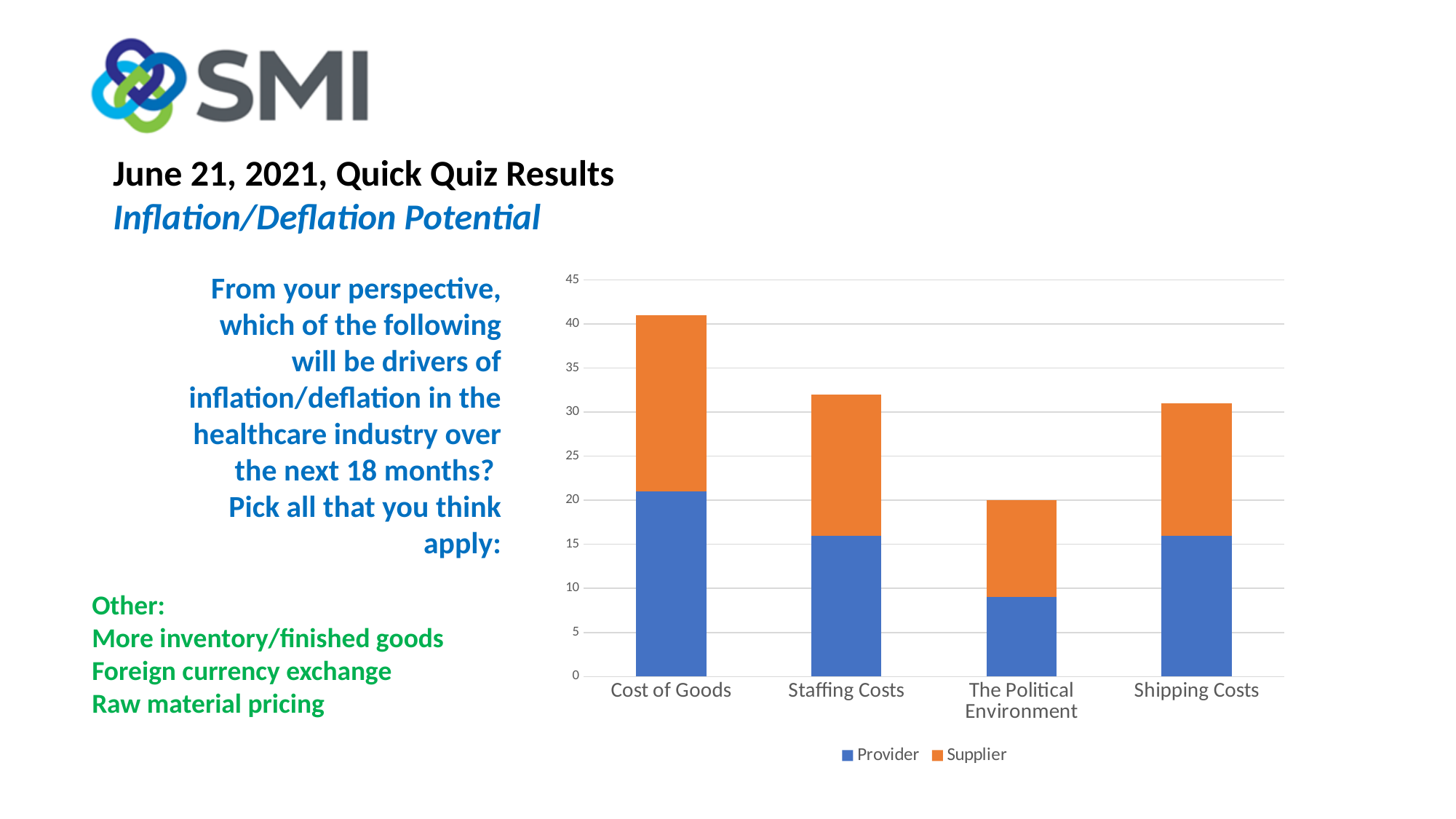
What kind of chart is shown on the slide? stacked bar chart Which category has the highest Provider value? Cost of Goods Is the Provider value for The Political Environment greater or less than 10? less Is the total stacked value for The Political Environment greater or less than 25? less Which colour represents the Supplier series in the chart? orange Which is larger, the total stacked value for Cost of Goods or for Staffing Costs? Cost of Goods Which category has the shortest stacked bar overall? The Political Environment How many categories are shown on the x axis of the chart? 4 Is the total stacked value for Cost of Goods greater or less than 35? greater Which category has the tallest stacked bar overall? Cost of Goods How many series does the chart legend list? 2 Which category has the lowest Provider value? The Political Environment